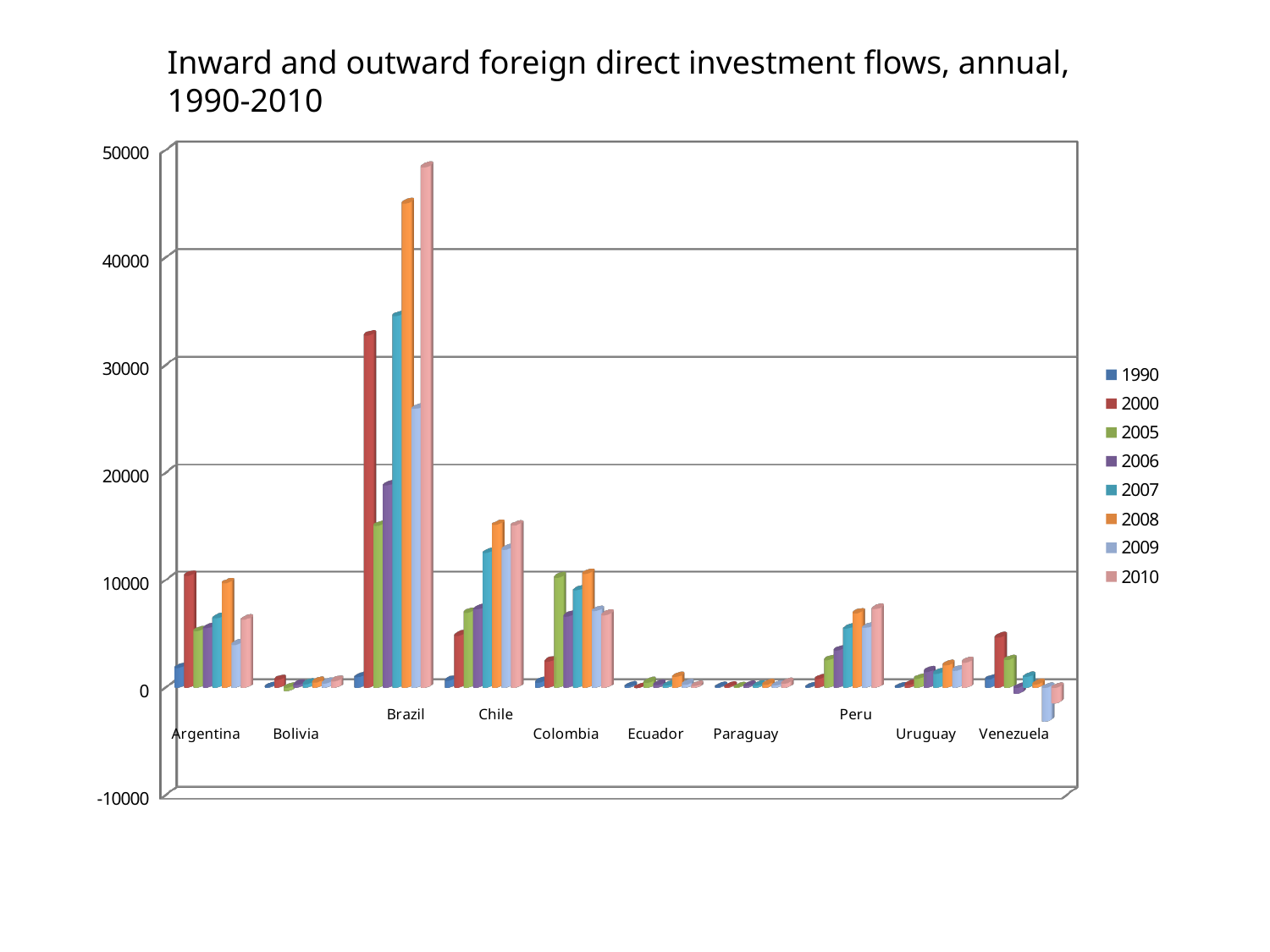
How many series does the legend list? 8 Is the value for Venezuela in 2009 greater or less than 0? less Which country has the tallest bar in the chart? Brazil For Brazil, which year has the highest bar? 2010 Is the value for Chile in 2008 greater or less than 10000? greater How many countries are shown on the x axis of the chart? 10 For Venezuela, which year has the lowest bar? 2009 Is the value for Brazil in 2010 greater or less than 40000? greater Which is larger for Brazil: the 2009 value or the 2010 value? 2010 What is the title of the chart? Inward and outward foreign direct investment flows, annual, 1990-2010 What kind of chart is shown on the slide? Bar chart